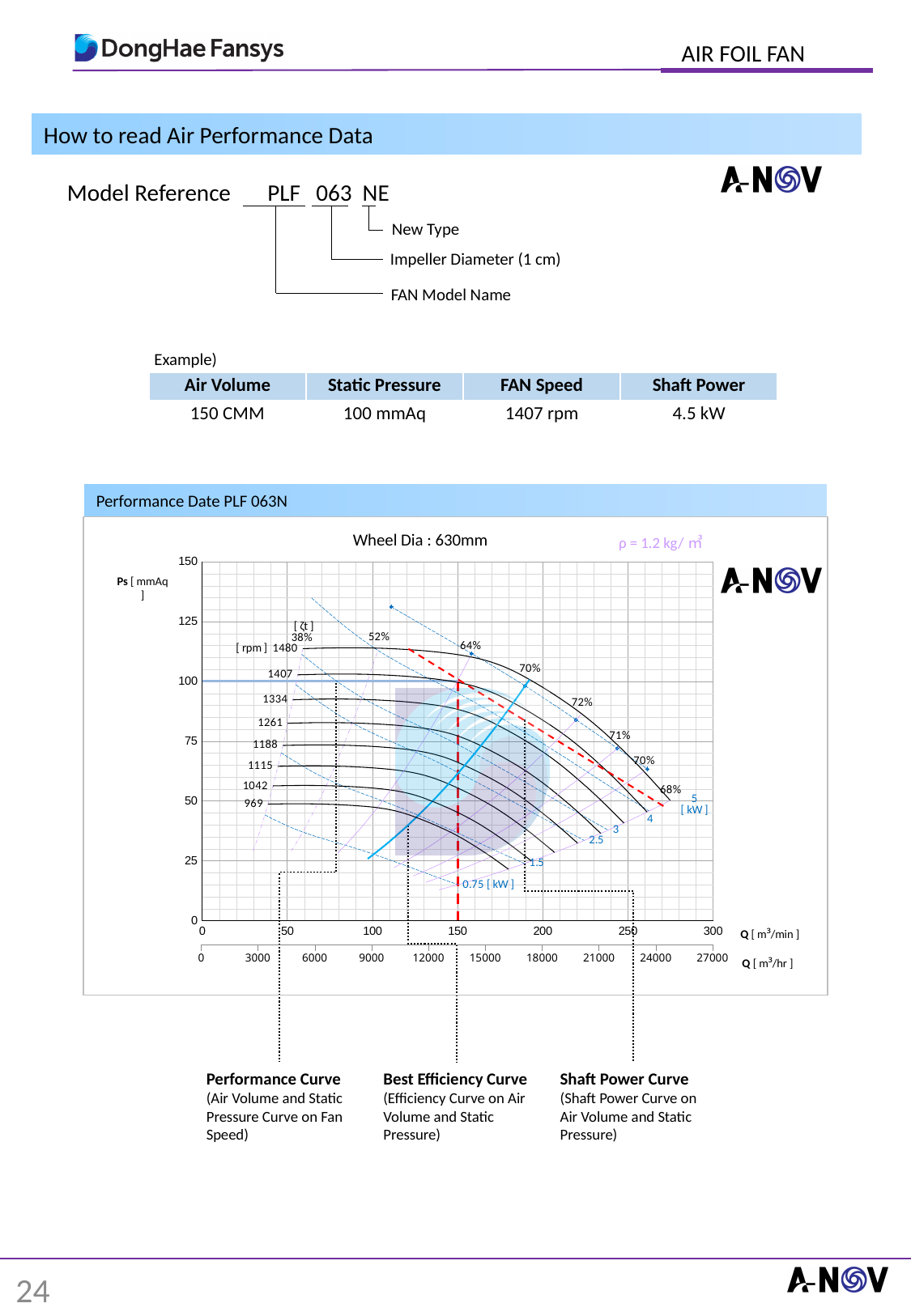
What is the lowest shaft power curve labelled on the chart? 0.75 [kW] What is the maximum value shown on the Q [m³/hr] axis of the chart? 27000 What is the lowest fan speed labelled on the performance curves? 969 rpm What is the highest fan speed labelled on the performance curves? 1480 rpm What kind of chart is shown in the Performance Date PLF 063N panel? line chart Which rpm curve passes through the point Q = 150 m³/min and Ps = 100 mmAq marked by the dashed lines? 1407 What is the lowest efficiency value labelled on the chart? 38% What is the highest shaft power curve labelled on the chart? 5 [kW] How many fan speed (rpm) curves are labelled on the performance chart? 8 Along each fan speed curve, does static pressure rise or fall as air volume increases? fall What is the highest efficiency value labelled on the chart? 72% What wheel diameter is stated above the performance chart? 630mm